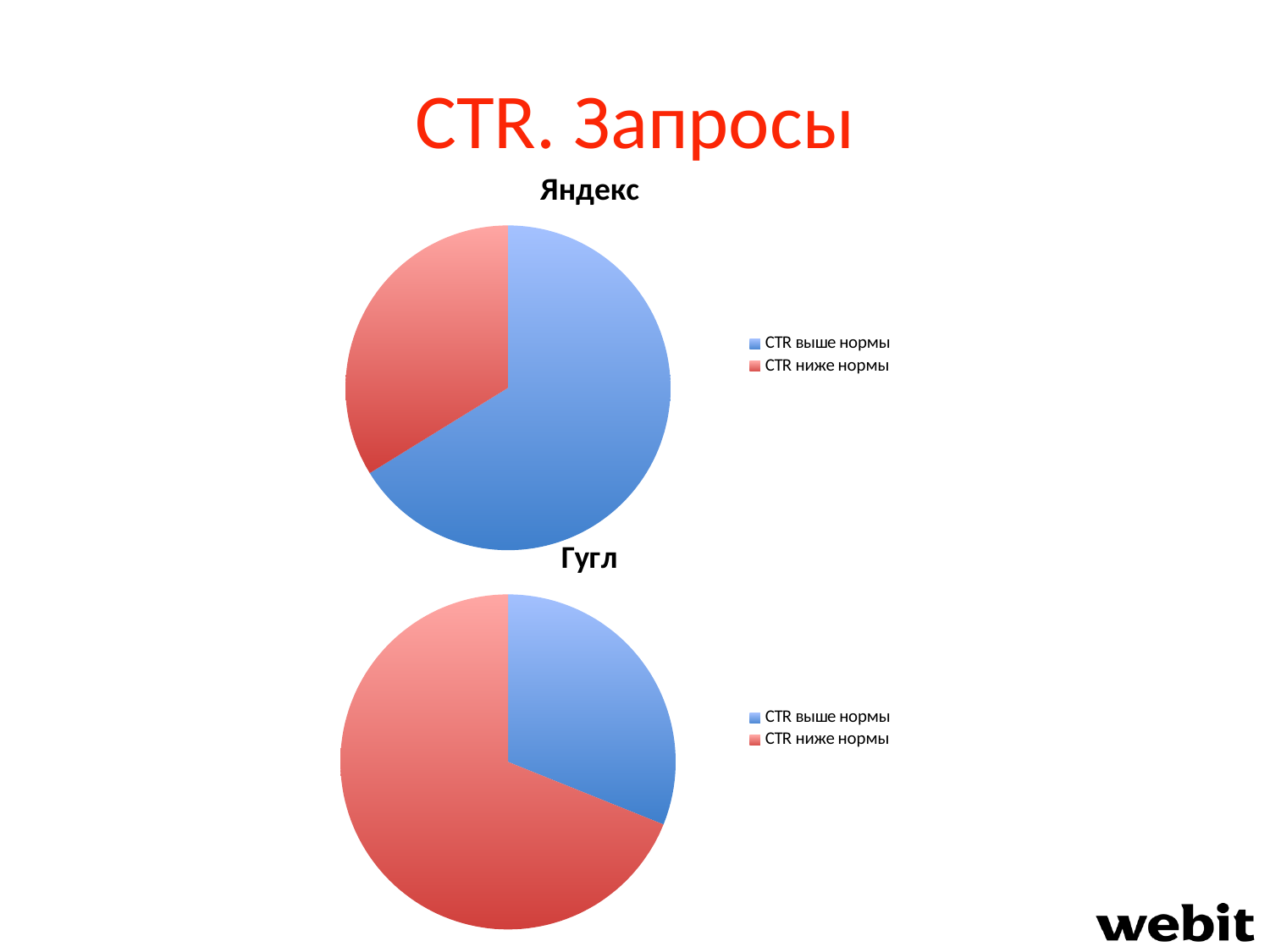
In the "Яндекс" chart, which is larger: CTR выше нормы or CTR ниже нормы? CTR выше нормы What kind of chart is the "Яндекс" chart? pie chart What is the title of the top chart on the slide? Яндекс In the "Гугл" chart, what colour is the slice for CTR ниже нормы? red How many entries does the legend of the "Гугл" chart list? 2 In the "Яндекс" chart, which category has the smallest slice? CTR ниже нормы In the "Гугл" chart, which category has the largest slice? CTR ниже нормы What kind of chart is the "Гугл" chart? pie chart In the "Гугл" chart, which category has the smallest slice? CTR выше нормы In the "Яндекс" chart, which category has the largest slice? CTR выше нормы In the "Гугл" chart, which is larger: CTR выше нормы or CTR ниже нормы? CTR ниже нормы How many slices does the "Яндекс" pie chart have? 2